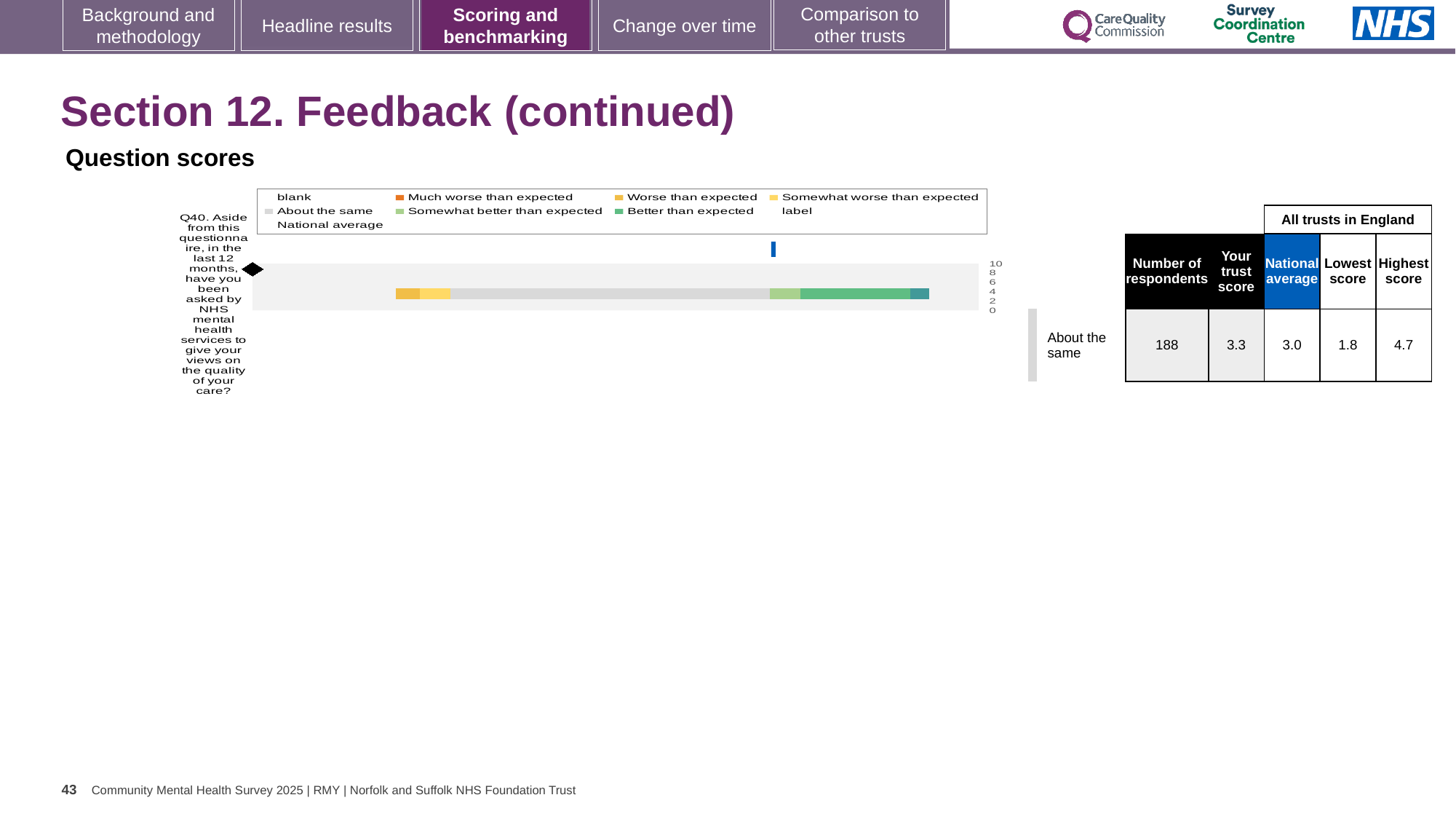
How many respondents answered Q40? 188 What kind of chart is used to show the Q40 question score? bar chart What is the national average for Q40 shown alongside the chart? 3.0 What is the difference between the highest and lowest scores among all trusts in England for Q40? 2.9 How many questions are plotted in the chart? 1 Which benchmarking category is the trust's Q40 score placed in? About the same What is the difference between the trust score and the national average for Q40? 0.3 What is the lowest score among all trusts in England for Q40? 1.8 Which is larger for Q40, the trust score or the national average? trust score Which legend entry is shown in orange? Much worse than expected What is the trust score for Q40 shown alongside the chart? 3.3 What is the highest score among all trusts in England for Q40? 4.7